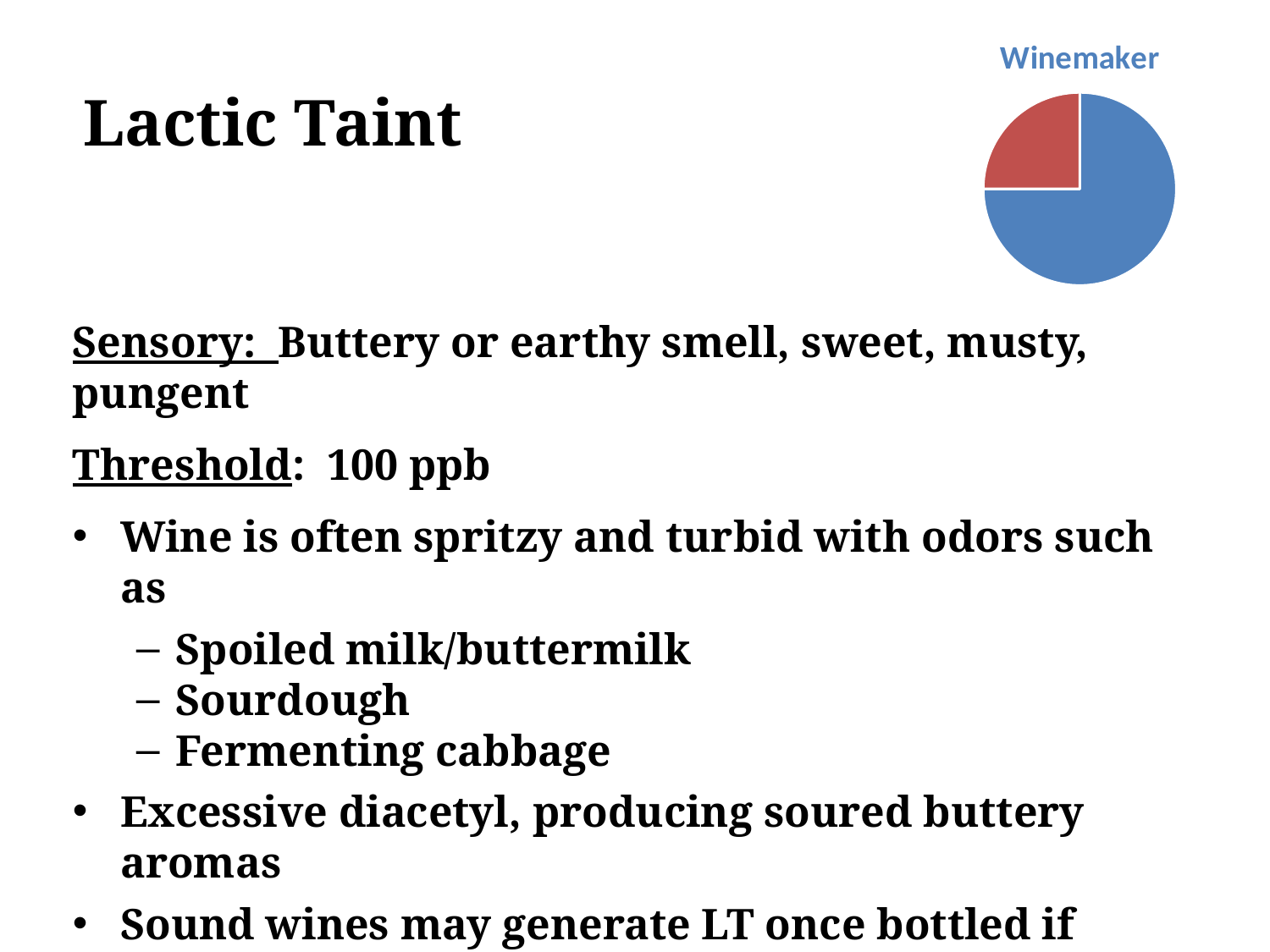
What is the title of the pie chart on the slide? Winemaker In the Winemaker pie chart, which colour slice is the largest? blue How many slices does the Winemaker pie chart have? 2 What two colours are used for the slices of the Winemaker pie chart? blue and red What kind of chart is shown in the top right of the slide? pie chart In the Winemaker pie chart, which colour slice is the smallest? red In the Winemaker pie chart, which slice is larger, the blue one or the red one? blue